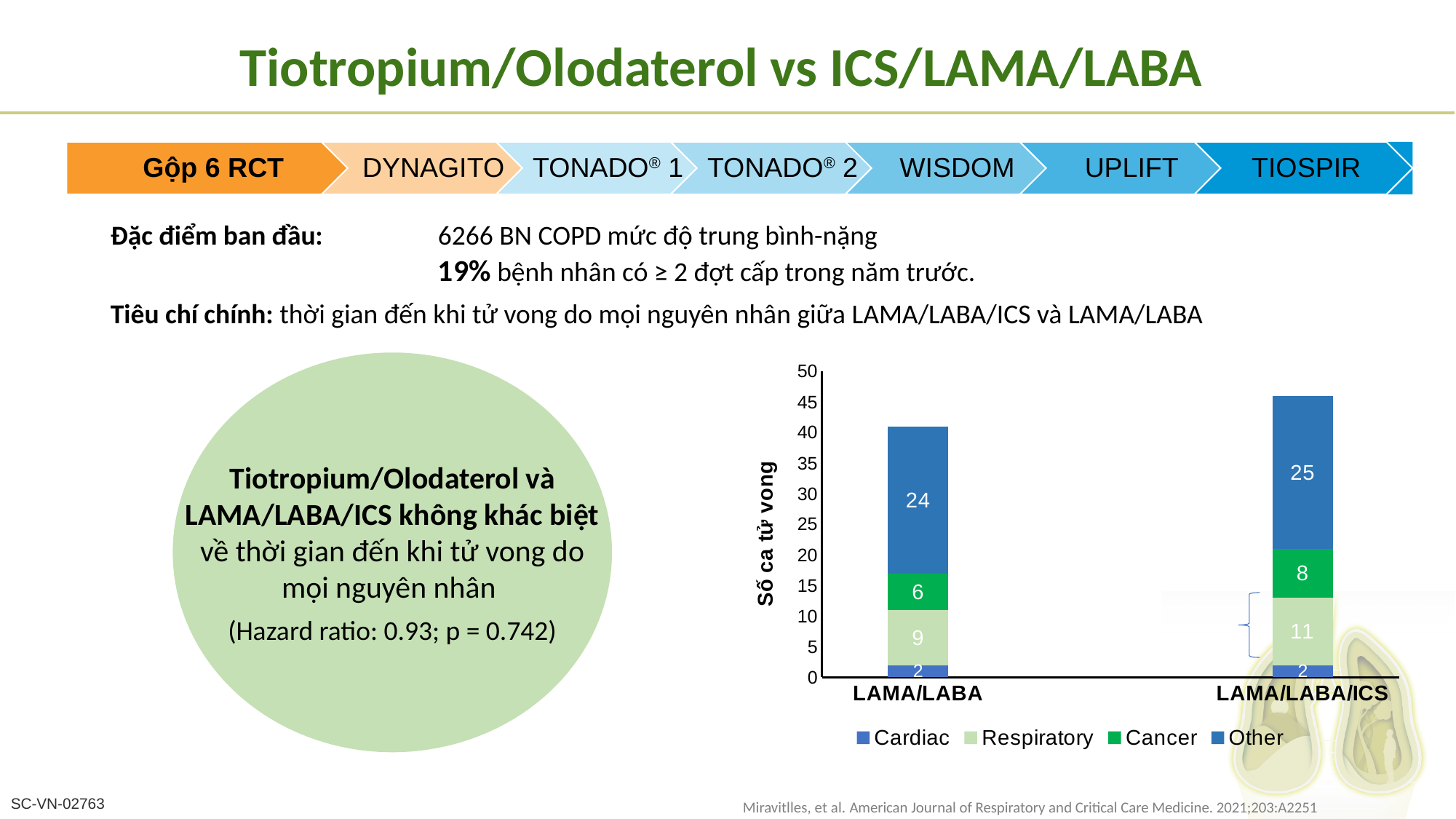
What is the Respiratory value for LAMA/LABA/ICS? 11 What is the Cancer value for LAMA/LABA? 6 What is the Other value for LAMA/LABA? 24 What is the label of the y axis of the chart? Số ca tử vong What is the total of the stacked bar for LAMA/LABA/ICS? 46 What is the Cardiac value for LAMA/LABA/ICS? 2 What type of chart is shown on the slide? Stacked bar chart How many categories are shown on the x axis of the chart? 2 What is the difference between the Other values for LAMA/LABA/ICS and LAMA/LABA? 1 What is the total of the stacked bar for LAMA/LABA? 41 How many series does the chart legend list? 4 Which category has the larger Cancer value, LAMA/LABA or LAMA/LABA/ICS? LAMA/LABA/ICS